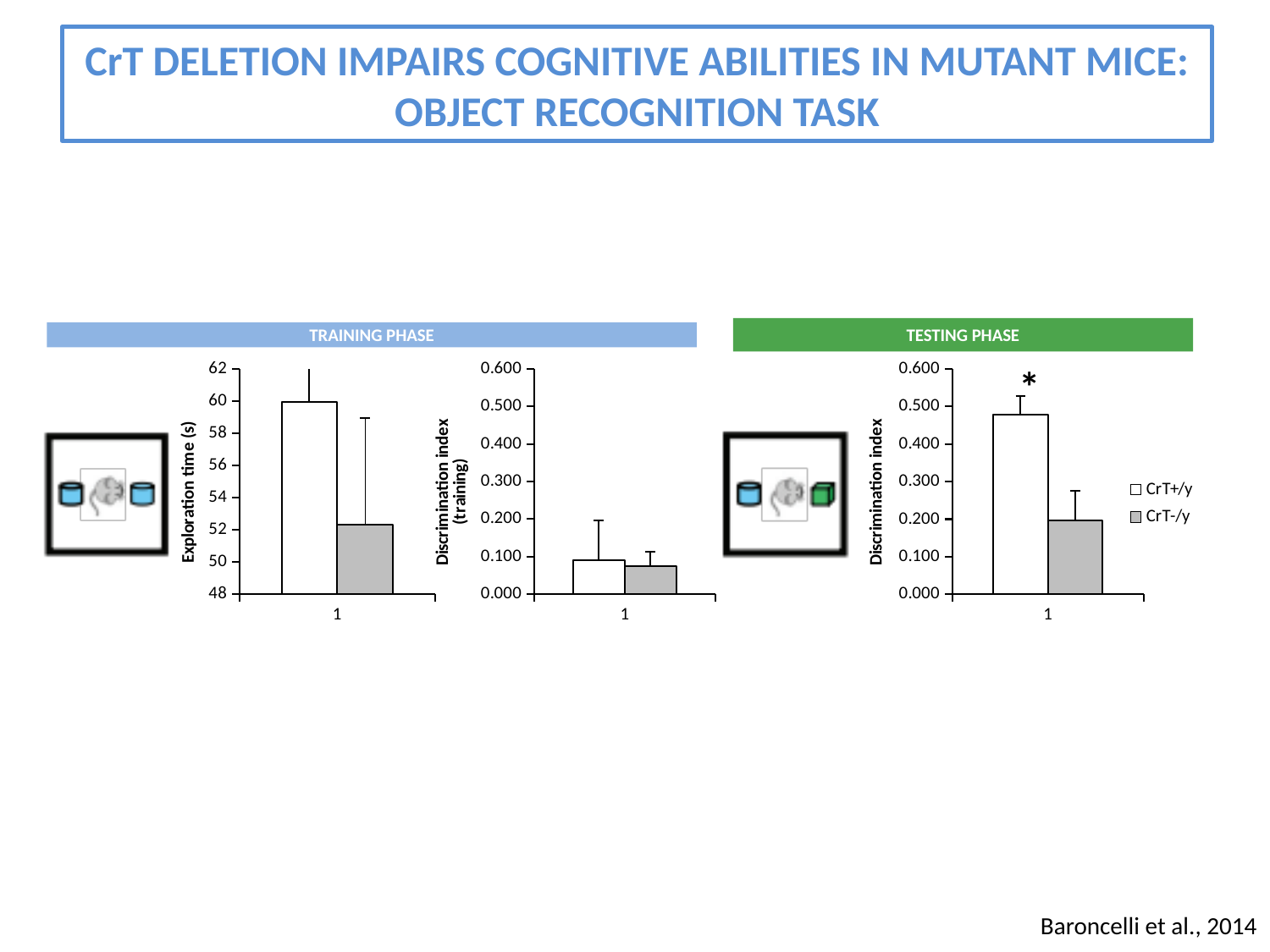
What is the y-axis title of the left chart on the slide? Exploration time (s) In the middle chart (Discrimination index, training), is the value for CrT-/y greater or less than 0.100? less Which series is shown with grey bars in the charts on the slide? CrT-/y In the right chart (Testing phase, Discrimination index), is the value for CrT+/y greater or less than 0.400? greater In the left chart (Exploration time), is the value for CrT+/y greater or less than 58? greater How many series does the legend on the slide list? 2 In the left chart (Exploration time), which series has the higher value, CrT+/y or CrT-/y? CrT+/y What kind of chart is the left chart (Exploration time) on the slide? bar chart In the right chart (Testing phase, Discrimination index), which series has the higher value, CrT+/y or CrT-/y? CrT+/y